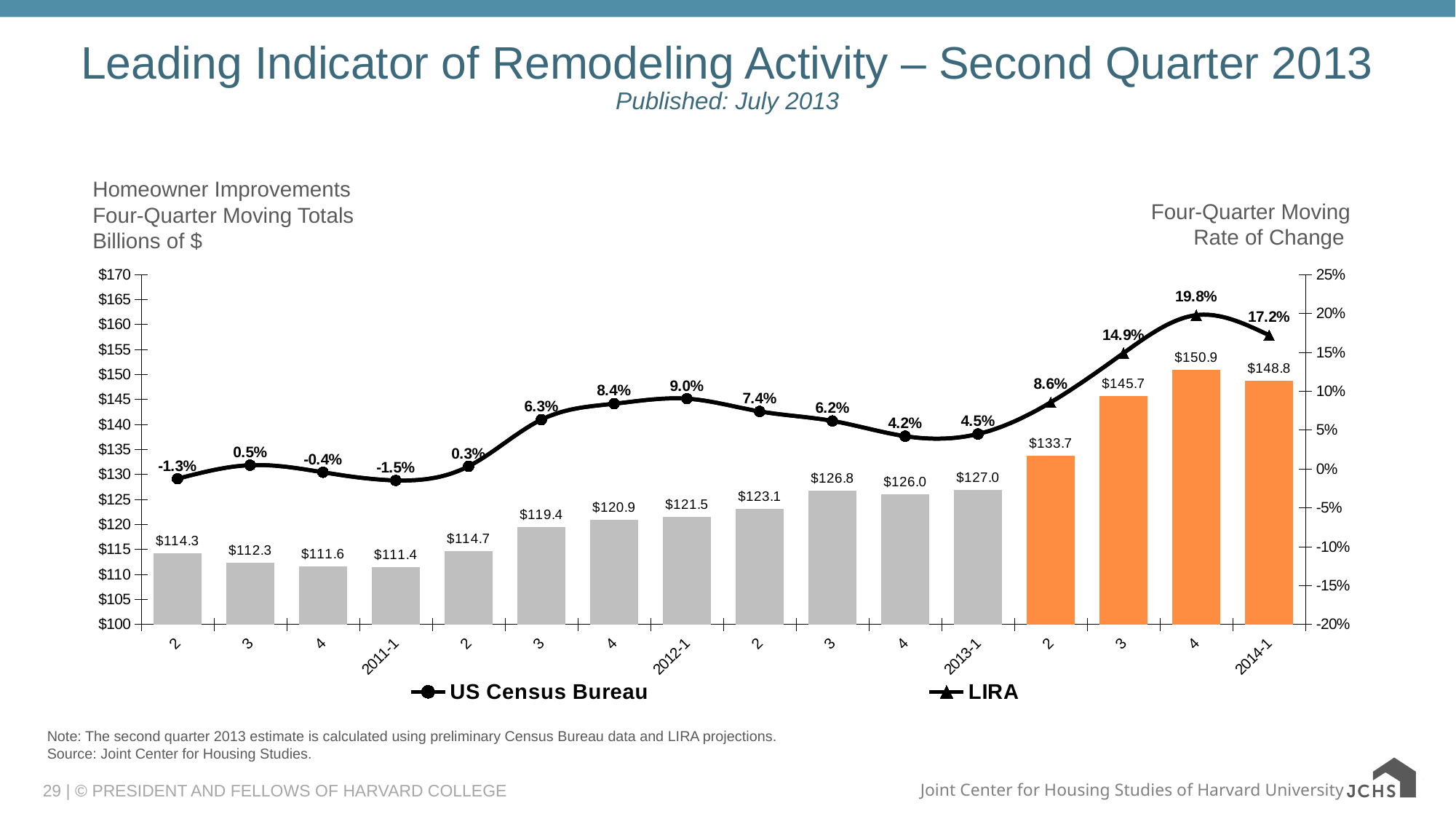
Which quarter has the lowest four-quarter moving total? 2011-1 ($111.4) Does the four-quarter moving total rise or fall from 2013-1 to 2014-1? Rise Which is larger, the rate of change for 2012-1 or for 2013-1? 2012-1 (9.0%) What is the four-quarter moving total (billions of $) for 2014-1? $148.8 What is the highest four-quarter moving rate of change shown on the line? 19.8% How many series does the legend list? 2 Which quarter has the highest four-quarter moving total? 4 (the quarter just before 2014-1, $150.9) What is the four-quarter moving rate of change shown for 2012-1? 9.0% What is the rate of change shown for 2011-1? -1.5% How many quarters are plotted along the x axis? 16 What is the difference between the four-quarter moving totals for 2014-1 and 2013-1? $21.8 What is the four-quarter moving total for 2013-1? $127.0